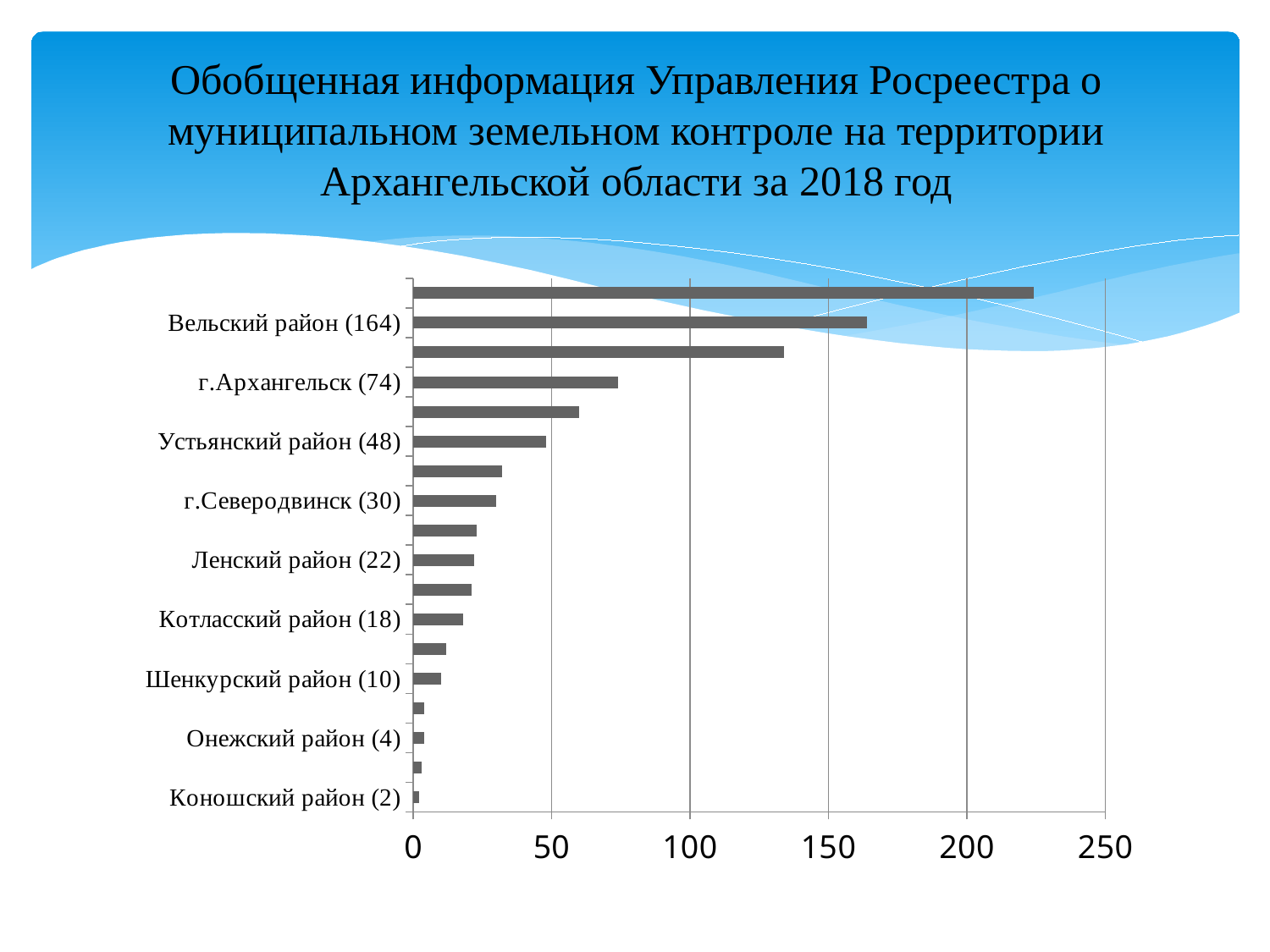
What is the value for г.Архангельск? 74 Among the labelled categories, which has the lowest value? Коношский район What is the value for Коношский район? 2 What is the highest tick value shown on the horizontal axis? 250 What is the value for Устьянский район? 48 How many bars are plotted in the chart? 18 What kind of chart is shown on the slide? bar chart Is the value of the topmost bar greater or less than 200? greater Which has a larger value, г.Северодвинск or Ленский район? г.Северодвинск What is the difference between the values for Вельский район and г.Архангельск? 90 What is the value for Шенкурский район? 10 What is the value for Вельский район? 164